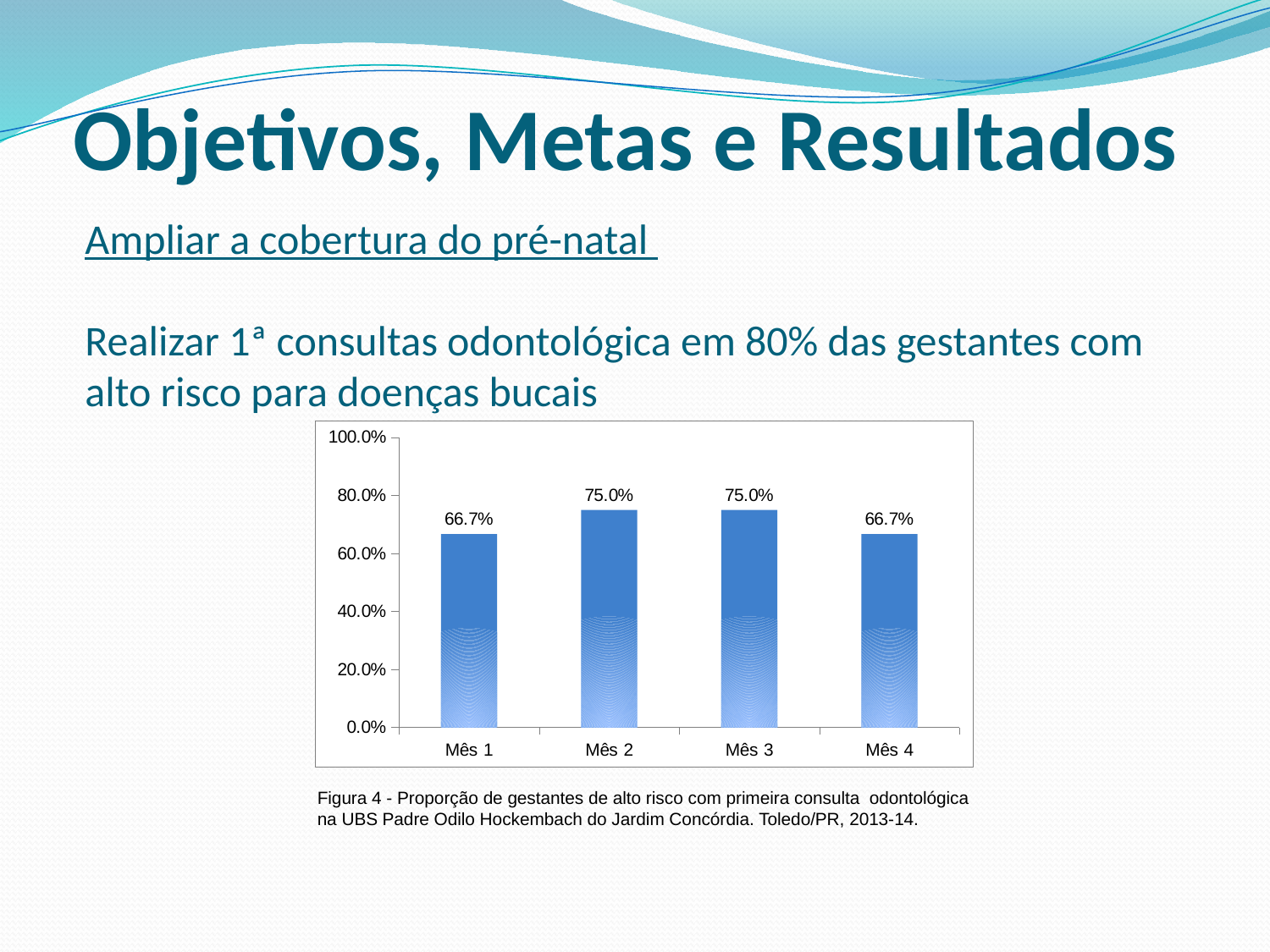
What is the value for Mês 4? 66.7% What is the value for Mês 1? 66.7% Which months have the lowest value? Mês 1 and Mês 4 How many months are shown on the x axis? 4 What is the highest value shown on the y axis? 100.0% Does the value rise or fall from Mês 3 to Mês 4? fall What kind of chart is shown on the slide? bar chart Which is larger, the value for Mês 3 or the value for Mês 4? Mês 3 Which months have the highest value? Mês 2 and Mês 3 What is the difference between the values for Mês 2 and Mês 1? 8.3% Is the value for Mês 2 greater or less than 80.0%? less What is the value for Mês 2? 75.0%